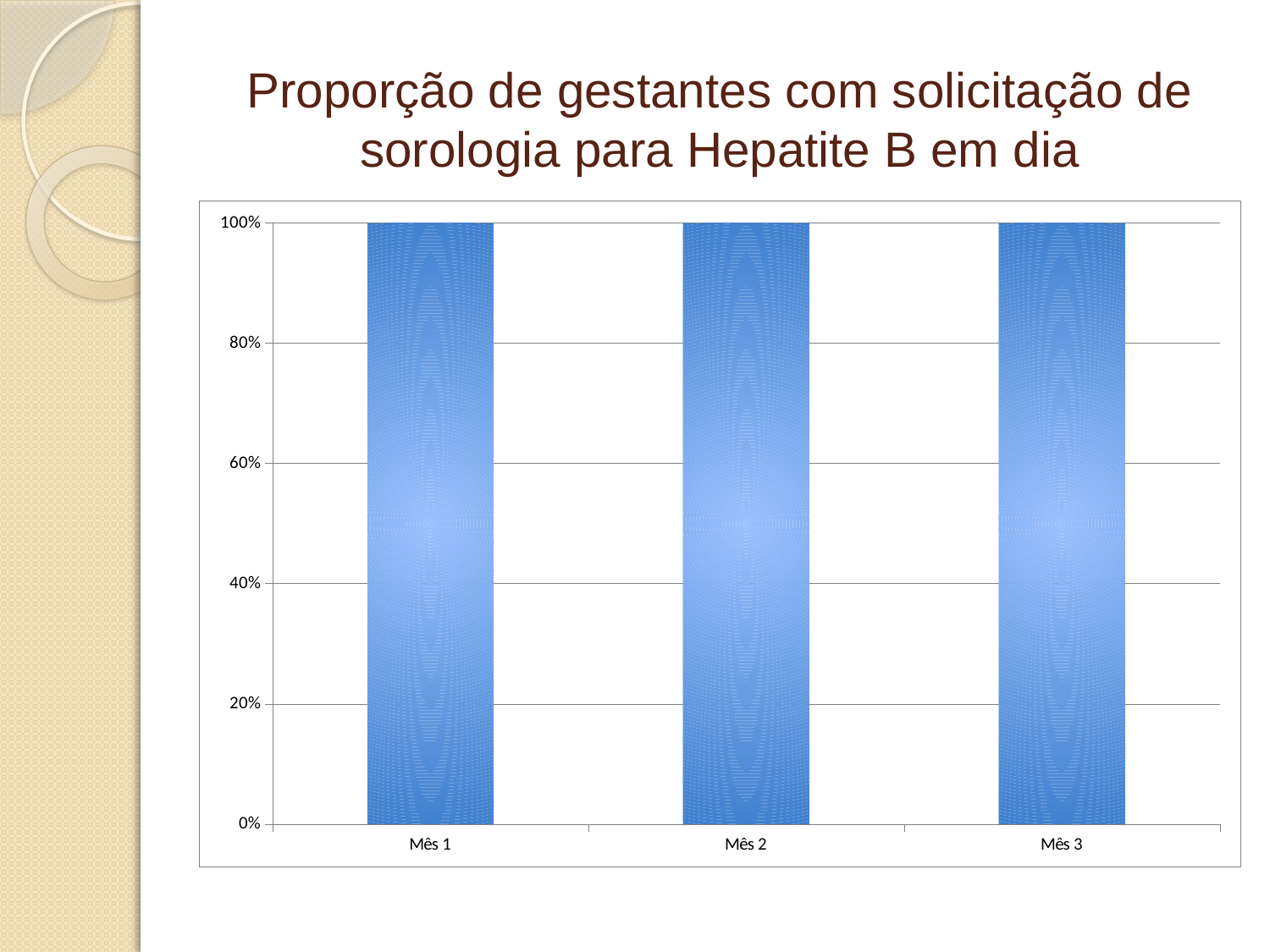
How many categories are shown on the x axis? 3 What is the difference between the values for Mês 1 and Mês 3? 0% What is the value for Mês 3? 100% What kind of chart is shown on the slide? bar chart Is the value for Mês 2 greater or less than 80%? greater What is the value for Mês 1? 100% What is the highest value shown on the y axis? 100% Is the value for Mês 3 greater or less than 60%? greater What is the label of the first category on the x axis? Mês 1 What is the title of the slide? Proporção de gestantes com solicitação de sorologia para Hepatite B em dia